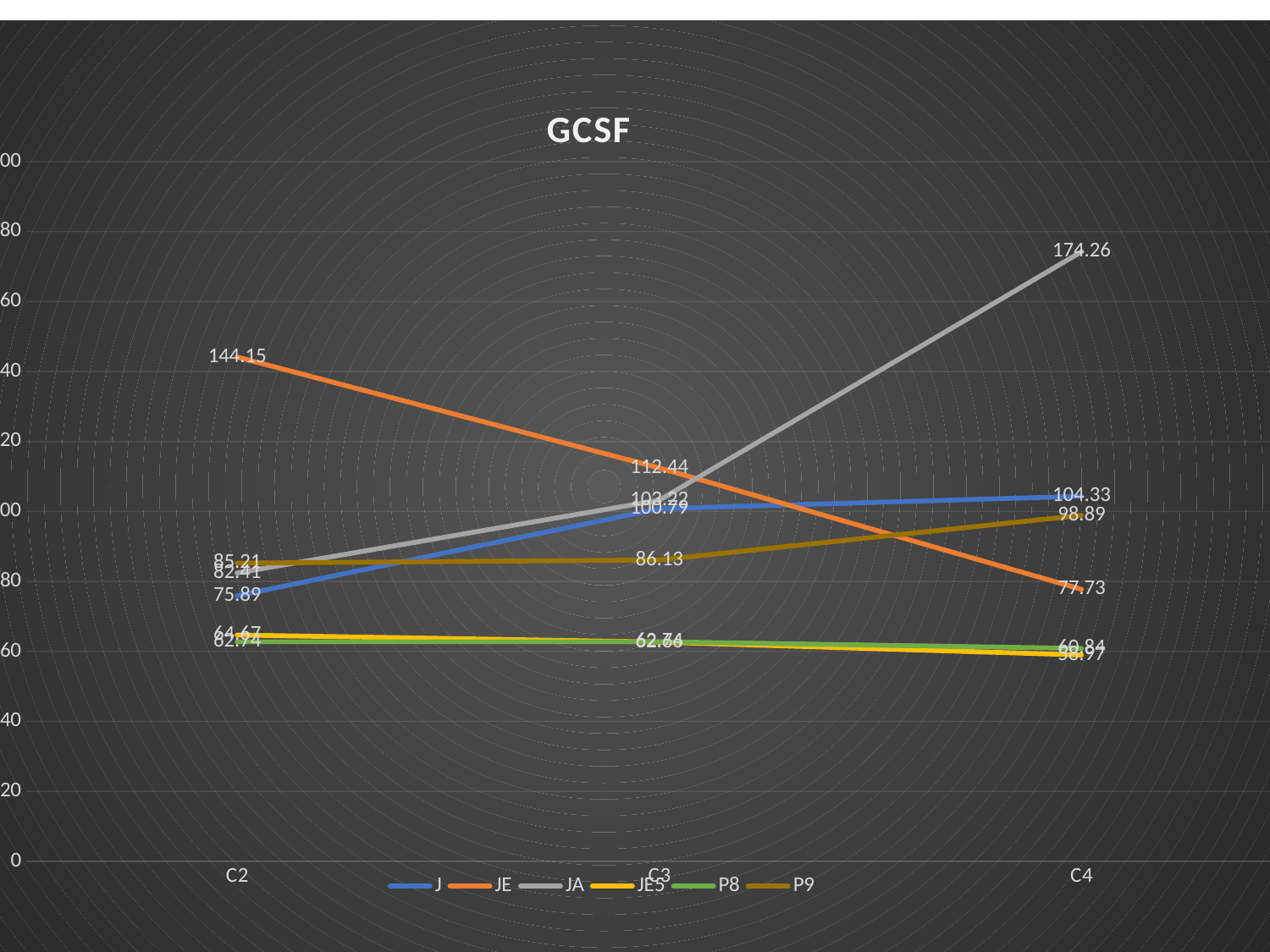
What is the difference between the JE value at C2 and at C4? 66.42 How many series does the legend list? 6 At C4, which is larger, J or P9? J What is the value of P9 at C3? 86.13 Which series has the highest value at C4? JA What kind of chart is shown on the slide? line chart How many categories are on the x axis? 3 What is the value of JE at C2? 144.15 What is the title of the chart? GCSF What is the value of JA at C4? 174.26 What is the value of J at C4? 104.33 Does the JE series rise or fall from C2 to C4? fall